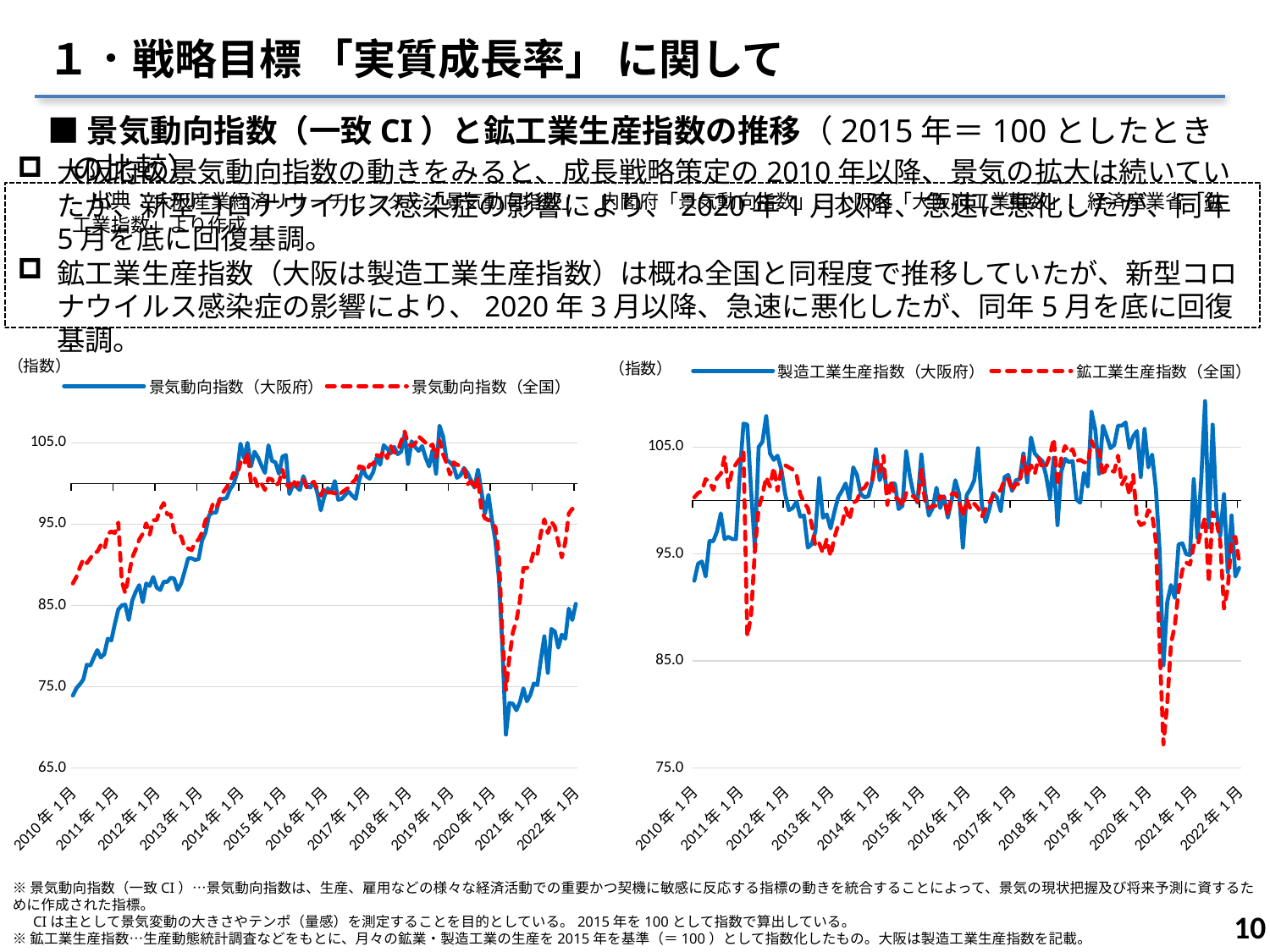
How many series does the legend of the right chart list? 2 In the left chart, is the value of 景気動向指数（全国） at 2010年1月 greater or less than 85.0? greater In the right chart, which series is drawn as a solid blue line? 製造工業生産指数（大阪府） What kind of chart is the left chart (景気動向指数)? line chart How many series does the legend of the left chart list? 2 In the left chart, does 景気動向指数（大阪府） rise or fall from 2010年1月 to 2014年1月? rise How many year labels (2010年1月 to 2022年1月) are shown on the x axis of the left chart? 13 What kind of chart is the right chart (製造工業生産指数／鉱工業生産指数)? line chart In the left chart, is the lowest value of 景気動向指数（大阪府） in 2020 greater or less than 75.0? less In the right chart, is the lowest value of 鉱工業生産指数（全国） in 2020 greater or less than 85.0? less In the left chart, which series is drawn as a red dashed line? 景気動向指数（全国） In the left chart, at 2010年1月, which is higher: 景気動向指数（大阪府） or 景気動向指数（全国）? 景気動向指数（全国）